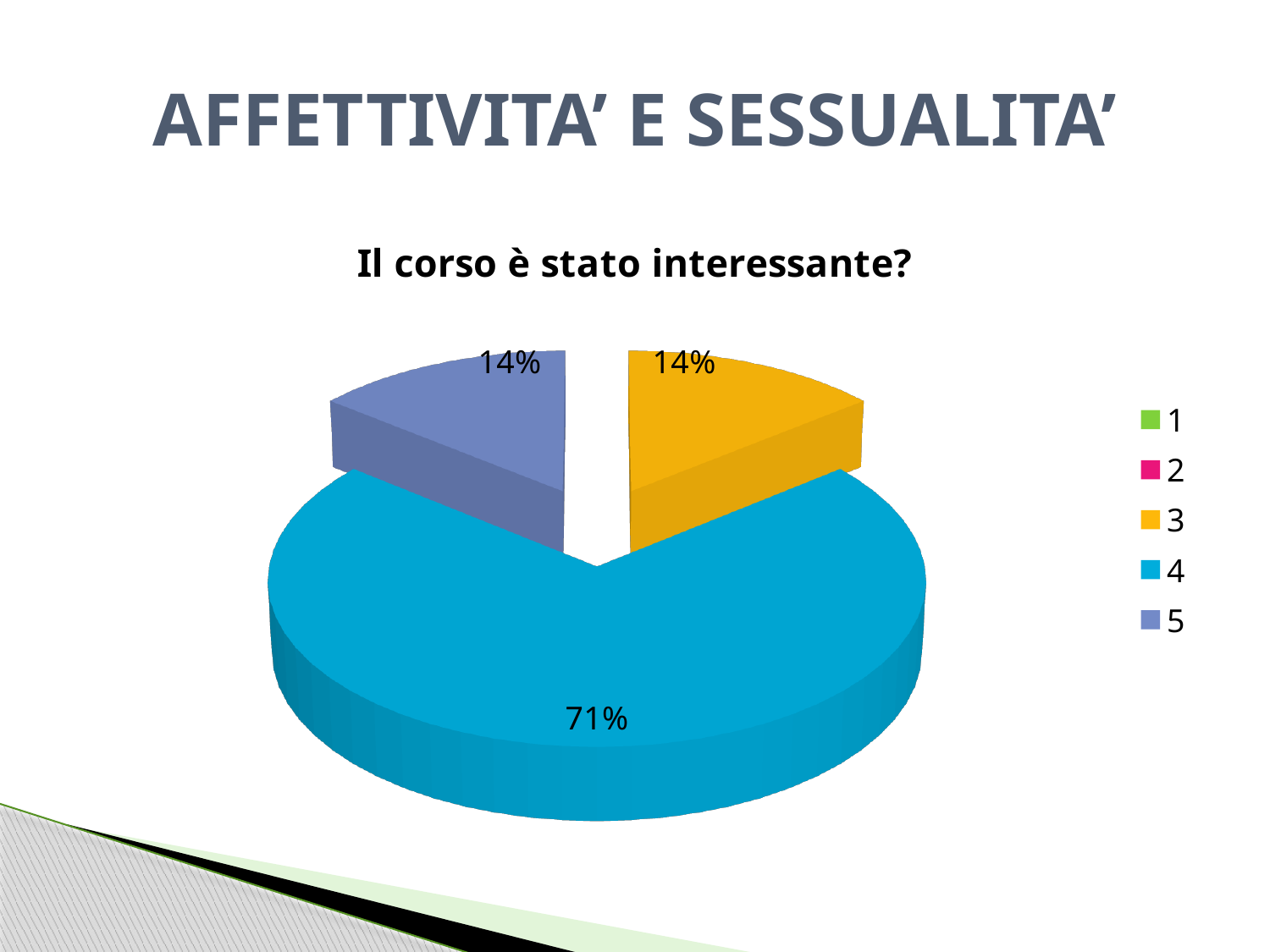
What is the combined share of categories 3 and 5? 28% What is the title of the chart? Il corso è stato interessante? Which category has the largest slice of the pie? 4 What kind of chart is shown on the slide? pie chart What colour is the slice for category 4? blue What share of the pie does category 3 represent? 14% What share of the pie does category 5 represent? 14% What share of the pie does category 4 represent? 71% Which is larger, the slice for category 4 or the slice for category 3? 4 How many slices are visible in the pie? 3 What is the difference between the share for category 4 and the share for category 5? 57% How many entries does the legend list? 5